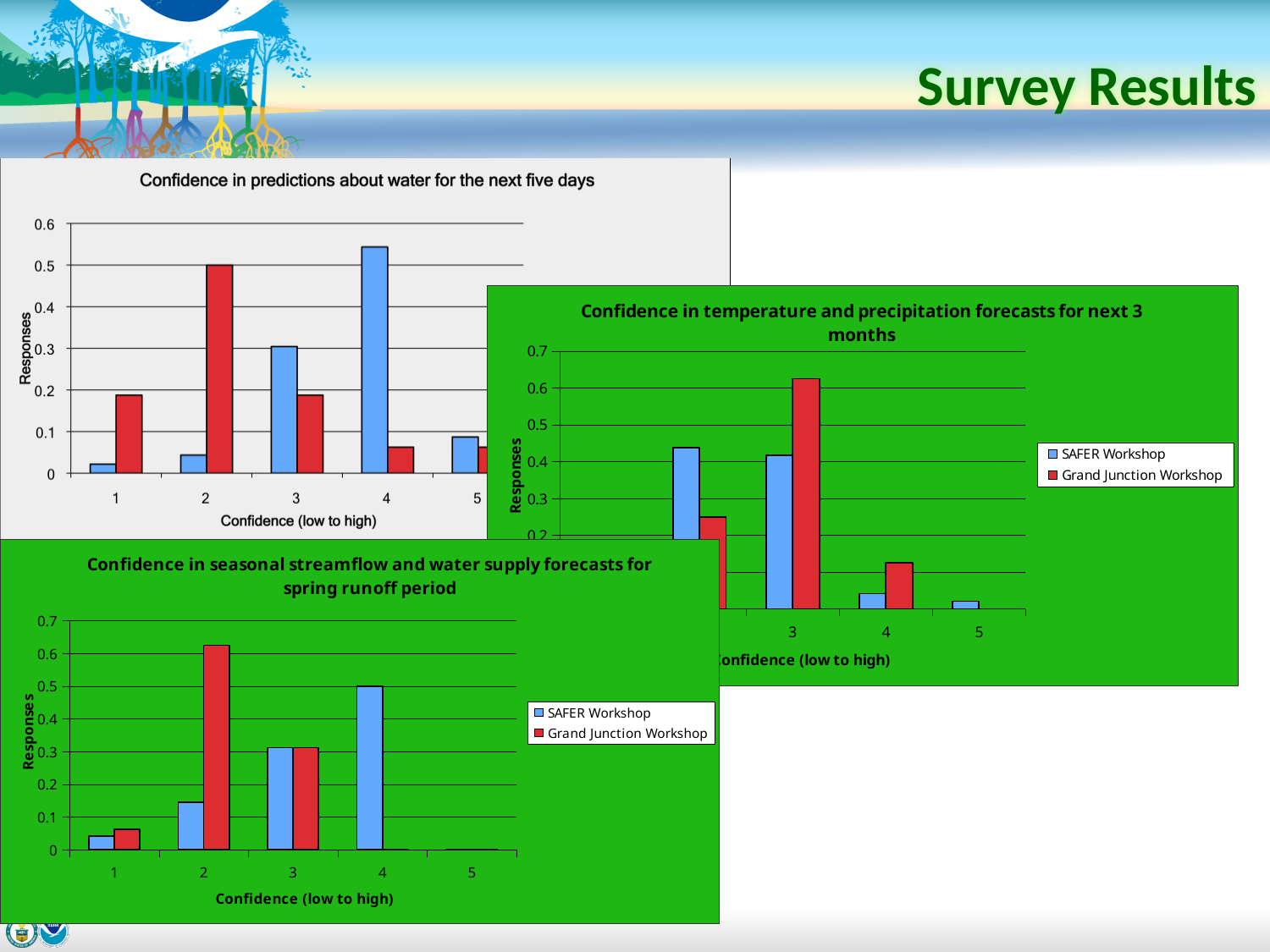
In the chart 'Confidence in seasonal streamflow and water supply forecasts for spring runoff period', is the Grand Junction Workshop value at confidence level 2 greater or less than 0.5? greater In the chart 'Confidence in seasonal streamflow and water supply forecasts for spring runoff period', at confidence level 2, which series has the larger value? Grand Junction Workshop What kind of chart is 'Confidence in seasonal streamflow and water supply forecasts for spring runoff period'? bar chart In the chart 'Confidence in predictions about water for the next five days', which confidence level has the tallest blue bar? 4 How many confidence levels are shown on the x axis of the chart 'Confidence in seasonal streamflow and water supply forecasts for spring runoff period'? 5 In the chart 'Confidence in seasonal streamflow and water supply forecasts for spring runoff period', which confidence level has the highest SAFER Workshop value? 4 In the chart 'Confidence in seasonal streamflow and water supply forecasts for spring runoff period', what is the SAFER Workshop response value at confidence level 4? 0.5 In the chart 'Confidence in seasonal streamflow and water supply forecasts for spring runoff period', which confidence level has the highest Grand Junction Workshop value? 2 In the chart 'Confidence in predictions about water for the next five days', what is the value of the red bar at confidence level 2? 0.5 In the chart 'Confidence in temperature and precipitation forecasts for next 3 months', is the Grand Junction Workshop value at confidence level 3 greater or less than 0.6? greater In the chart 'Confidence in seasonal streamflow and water supply forecasts for spring runoff period', what are the two legend entries? SAFER Workshop and Grand Junction Workshop In the chart 'Confidence in seasonal streamflow and water supply forecasts for spring runoff period', how many series does the legend list? 2